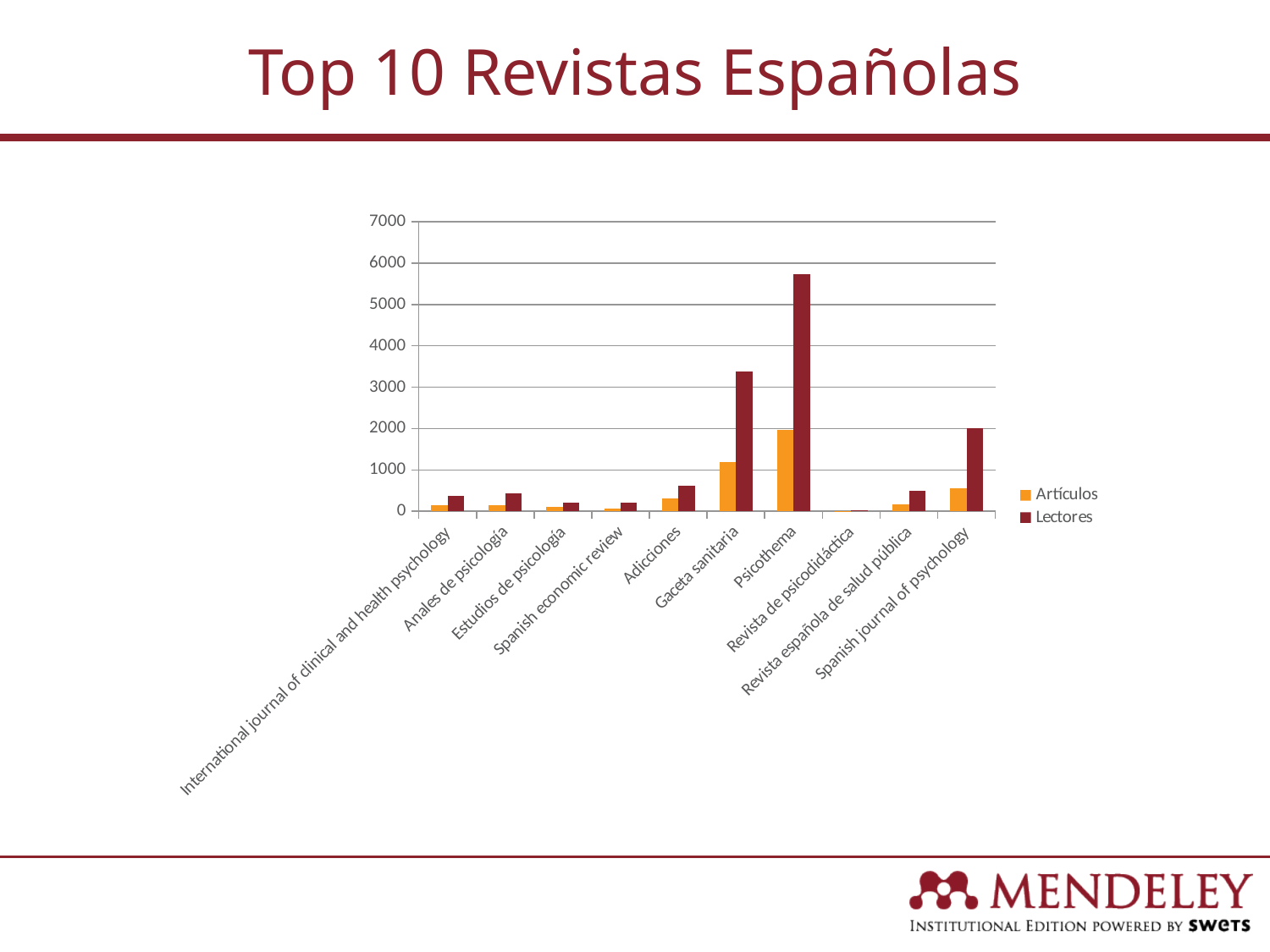
Is the Artículos value for Psicothema greater or less than 1000? greater Which has a larger Lectores value, Gaceta sanitaria or Adicciones? Gaceta sanitaria What is the title of the slide containing the chart? Top 10 Revistas Españolas For Psicothema, which series has the larger value, Artículos or Lectores? Lectores What kind of chart is shown on the slide? bar chart How many series does the legend list? 2 Is the Lectores value for Gaceta sanitaria greater or less than 3000? greater Which journal has the highest Lectores value? Psicothema Is the Lectores value for Psicothema greater or less than 5000? greater Which journal has the lowest Lectores value? Revista de psicodidáctica Which journal has the highest Artículos value? Psicothema How many journals (categories) are shown on the x axis? 10